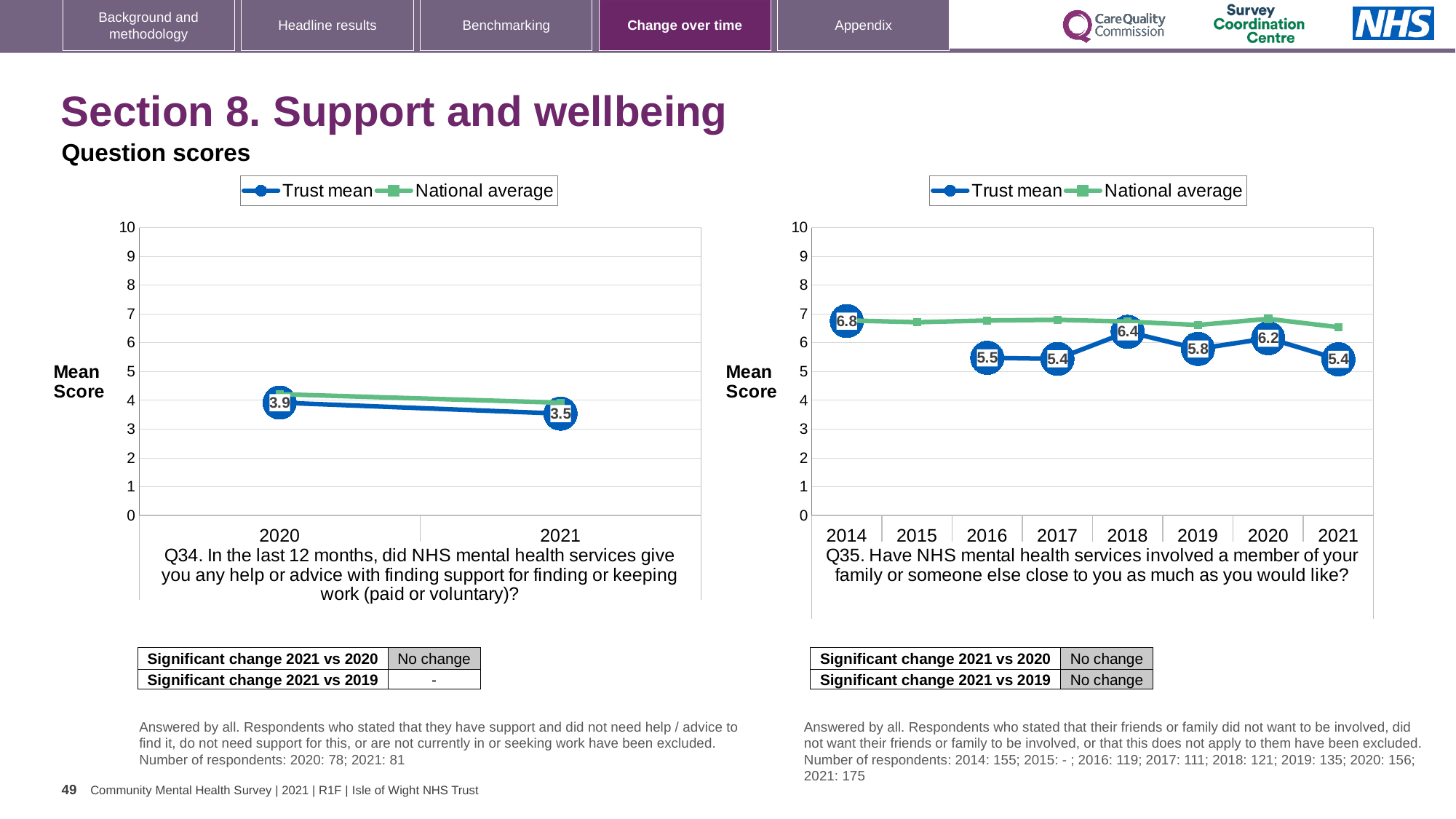
On the Q34 chart (left), what is the Trust mean for 2020? 3.9 How many series does the legend of the Q35 chart (right) list? 2 On the Q35 chart (right), is the Trust mean higher in 2018 or in 2019? 2018 On the Q34 chart (left), does the Trust mean rise or fall from 2020 to 2021? fall On the Q35 chart (right), which year has the highest Trust mean? 2014 On the Q35 chart (right), what is the Trust mean for 2014? 6.8 On the Q35 chart (right), is the National average for 2021 greater or less than 6? greater What type of chart is the Q34 chart (left)? Line chart On the Q35 chart (right), what is the Trust mean for 2018? 6.4 On the Q34 chart (left), what is the Trust mean for 2021? 3.5 On the Q35 chart (right), what is the difference between the Trust mean in 2020 and in 2021? 0.8 On the Q34 chart (left), by how much did the Trust mean fall from 2020 to 2021? 0.4